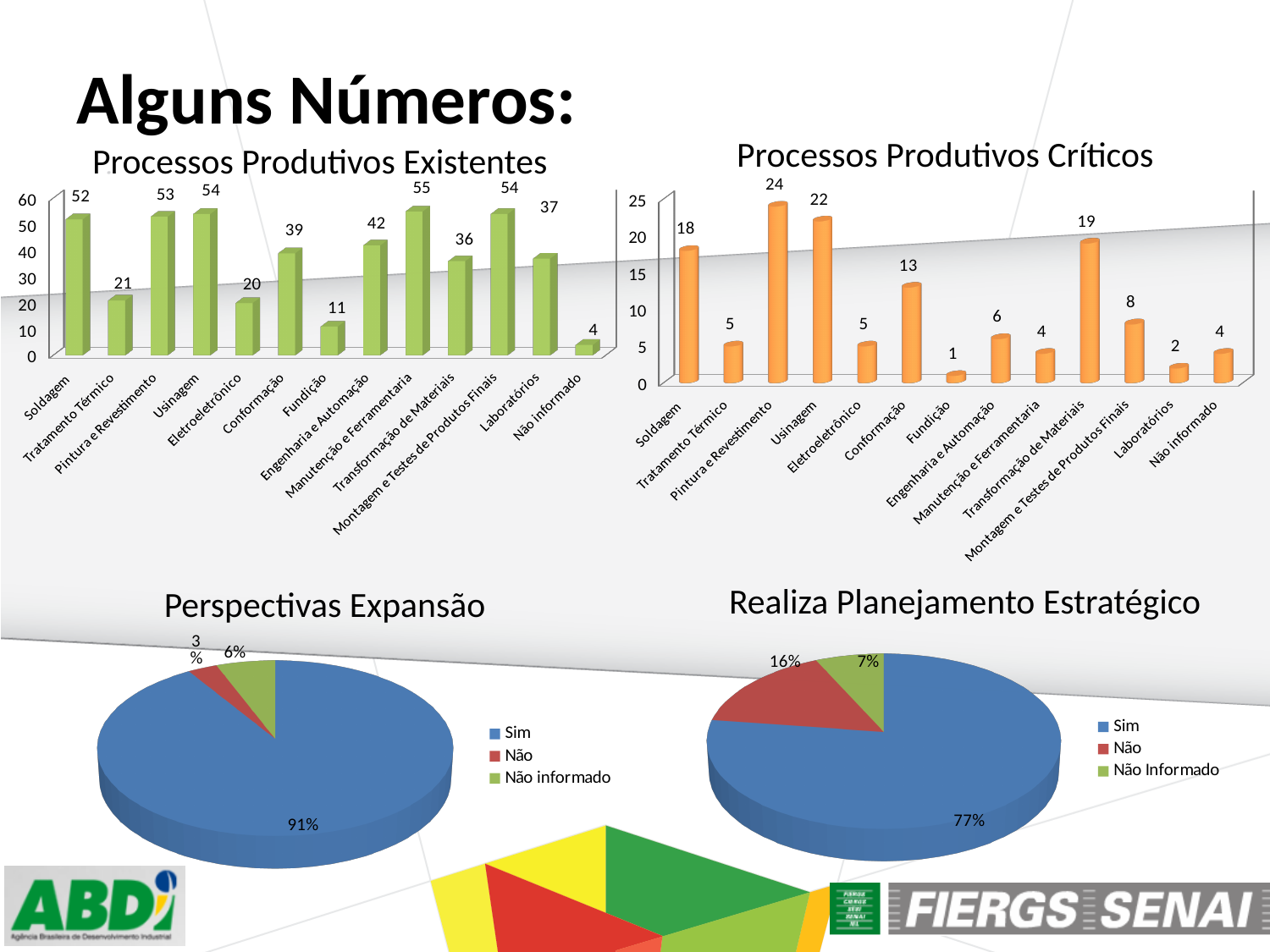
In the 'Processos Produtivos Críticos' chart, what is the value for Transformação de Materiais? 19 In the 'Processos Produtivos Existentes' chart, what is the difference between the values for Soldagem and Tratamento Térmico? 31 In the 'Realiza Planejamento Estratégico' pie chart, what share does 'Não' have? 16% How many categories are shown in the 'Processos Produtivos Críticos' chart? 13 In the 'Processos Produtivos Existentes' chart, which category has the lowest value? Não informado What type of chart is 'Perspectivas Expansão'? Pie chart In the 'Processos Produtivos Críticos' chart, which category has the highest value? Pintura e Revestimento In the 'Processos Produtivos Críticos' chart, which is larger, the value for Soldagem or the value for Usinagem? Usinagem In the 'Processos Produtivos Existentes' chart, what is the value for Conformação? 39 In the 'Perspectivas Expansão' pie chart, what share does 'Não informado' have? 6% In the 'Processos Produtivos Existentes' chart, which category has the highest value? Manutenção e Ferramentaria In the 'Processos Produtivos Críticos' chart, which category has the lowest value? Fundição